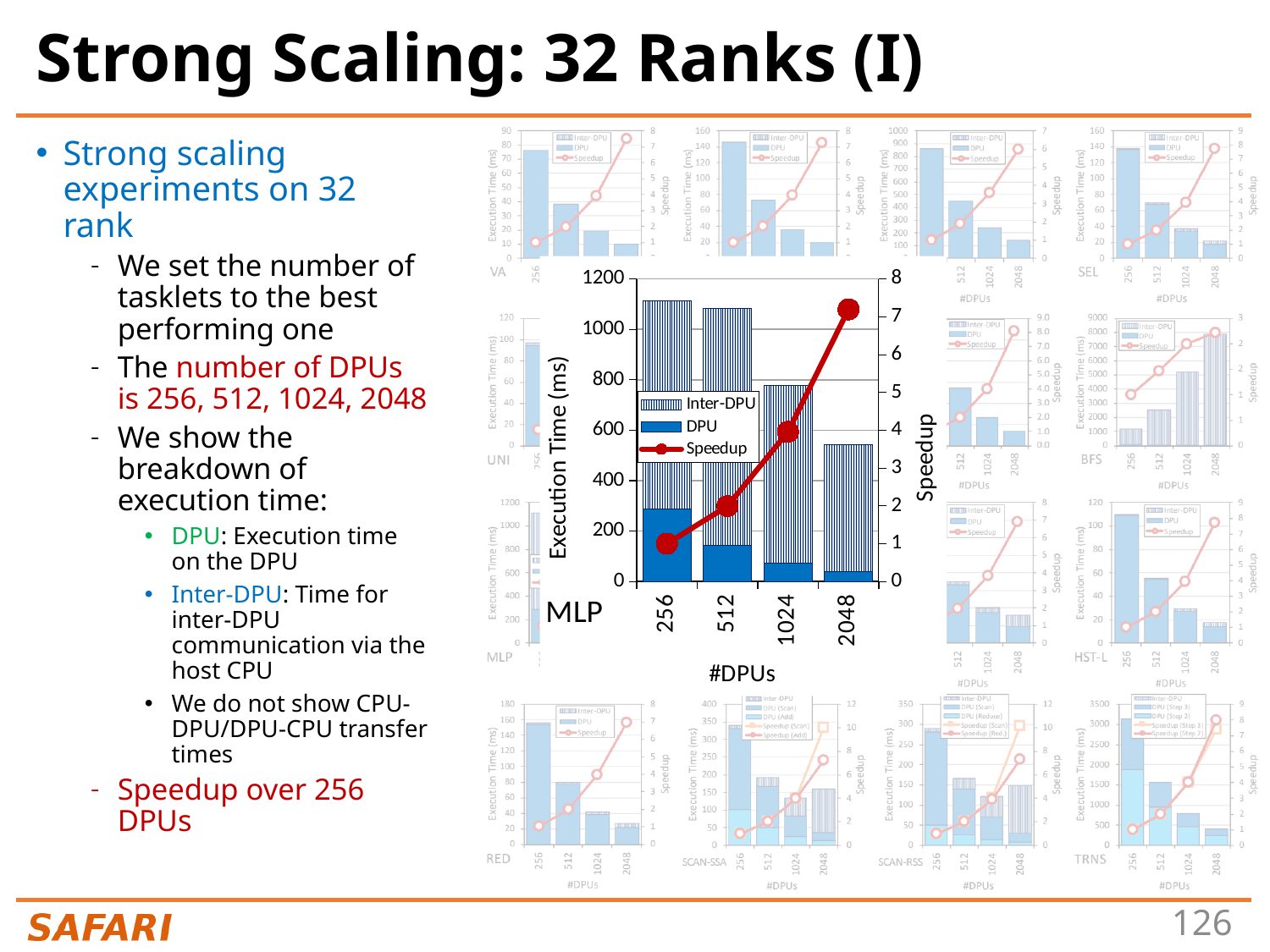
In the large MLP chart, which #DPUs category has the highest total execution time? 256 In the large MLP chart, which #DPUs category has the lowest total execution time? 2048 In the large MLP chart, which #DPUs category has the highest Speedup? 2048 In the large MLP chart, how many #DPUs categories are shown on the x axis? 4 In the large MLP chart, is the total execution time for 2048 DPUs greater or less than 600 ms? less In the large MLP chart, what is the Speedup value at 256 DPUs? 1 In the large MLP chart, does the total execution time rise or fall as the number of DPUs increases? fall In the large MLP chart, is the DPU execution time for 256 DPUs larger or smaller than for 512 DPUs? larger In the large MLP chart, how many series does the legend list? 3 In the large MLP chart, is the total execution time for 256 DPUs greater or less than 1000 ms? greater What is the x-axis title of the large MLP chart? #DPUs